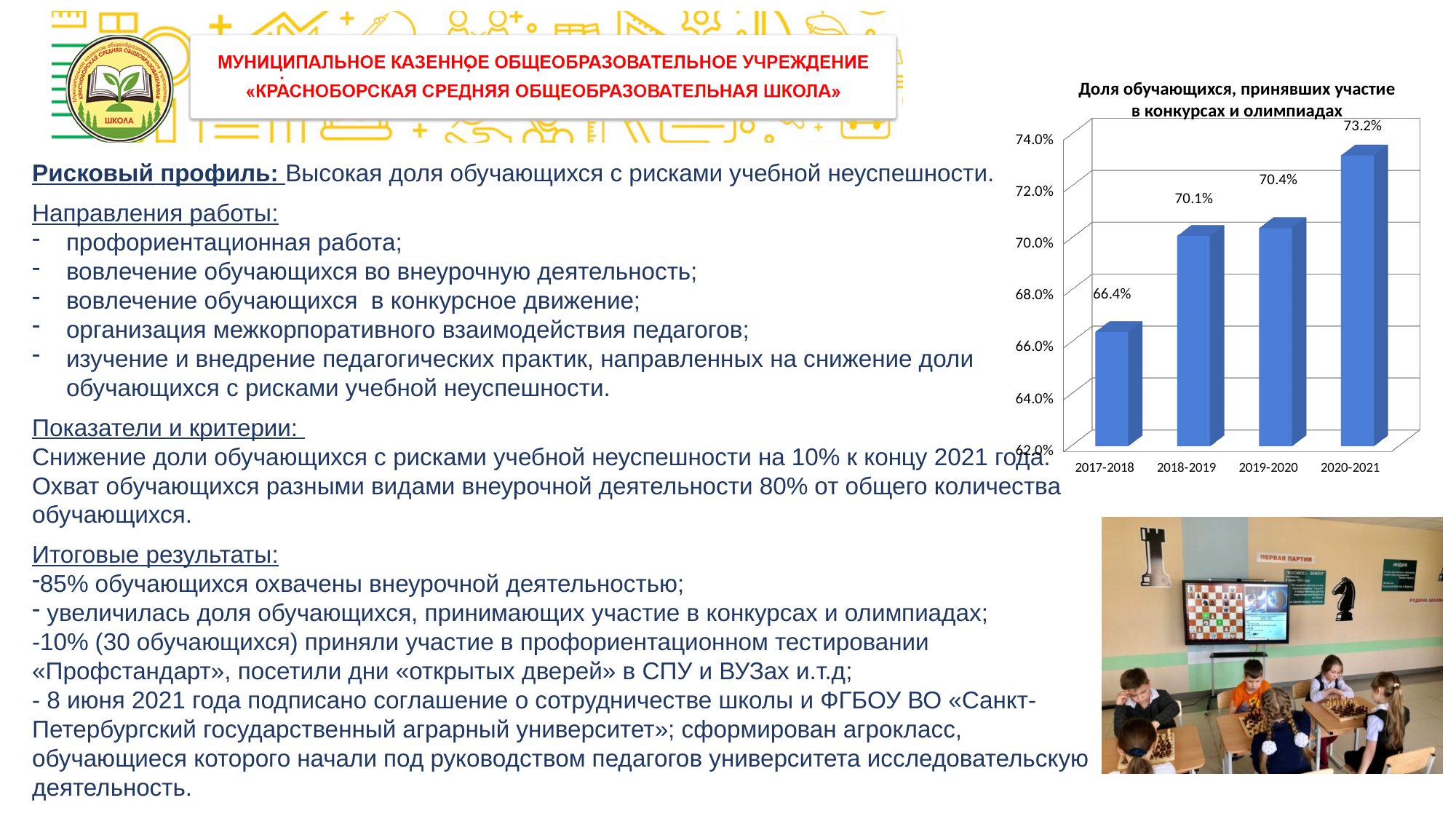
What is the value for 2020-2021 in the chart? 73.2% How many academic years are shown on the x axis of the chart? 4 What is the value for 2018-2019 in the chart? 70.1% What type of chart is used to show the share of students participating in competitions and olympiads? Bar chart Which academic year has the highest share of students participating in competitions and olympiads? 2020-2021 Do the values in the chart rise or fall from 2017-2018 to 2020-2021? Rise What is the value for 2019-2020 in the chart? 70.4% By how many percentage points does the value for 2020-2021 exceed the value for 2017-2018? 6.8 What is the value for 2017-2018 in the chart? 66.4% Which academic year has the lowest share of students participating in competitions and olympiads? 2017-2018 Which is larger, the value for 2019-2020 or the value for 2018-2019? 2019-2020 What is the difference between the values for 2018-2019 and 2017-2018? 3.7